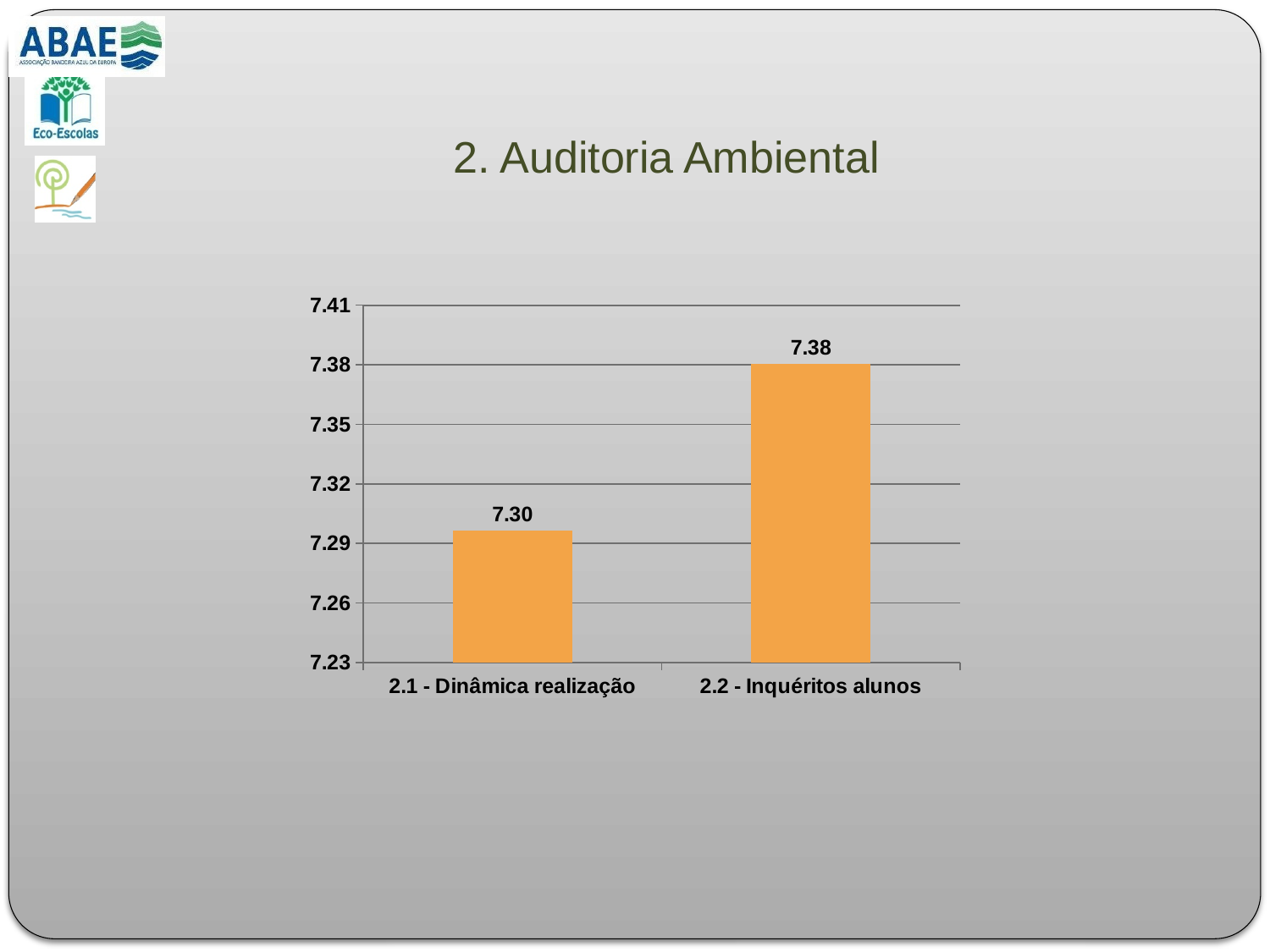
Which category has the lowest value? 2.1 - Dinâmica realização What is the title of the slide containing the chart? 2. Auditoria Ambiental How many categories are shown on the chart? 2 Is the value for 2.2 - Inquéritos alunos greater or less than 7.35? greater What kind of chart is shown on the slide? bar chart Do the values rise or fall from left to right along the x axis? rise Is the value for 2.1 - Dinâmica realização greater or less than 7.32? less Which category has the highest value? 2.2 - Inquéritos alunos What is the value for 2.1 - Dinâmica realização? 7.30 What is the difference between the values for 2.2 - Inquéritos alunos and 2.1 - Dinâmica realização? 0.08 Which is larger, the value for 2.1 - Dinâmica realização or the value for 2.2 - Inquéritos alunos? 2.2 - Inquéritos alunos What is the value for 2.2 - Inquéritos alunos? 7.38